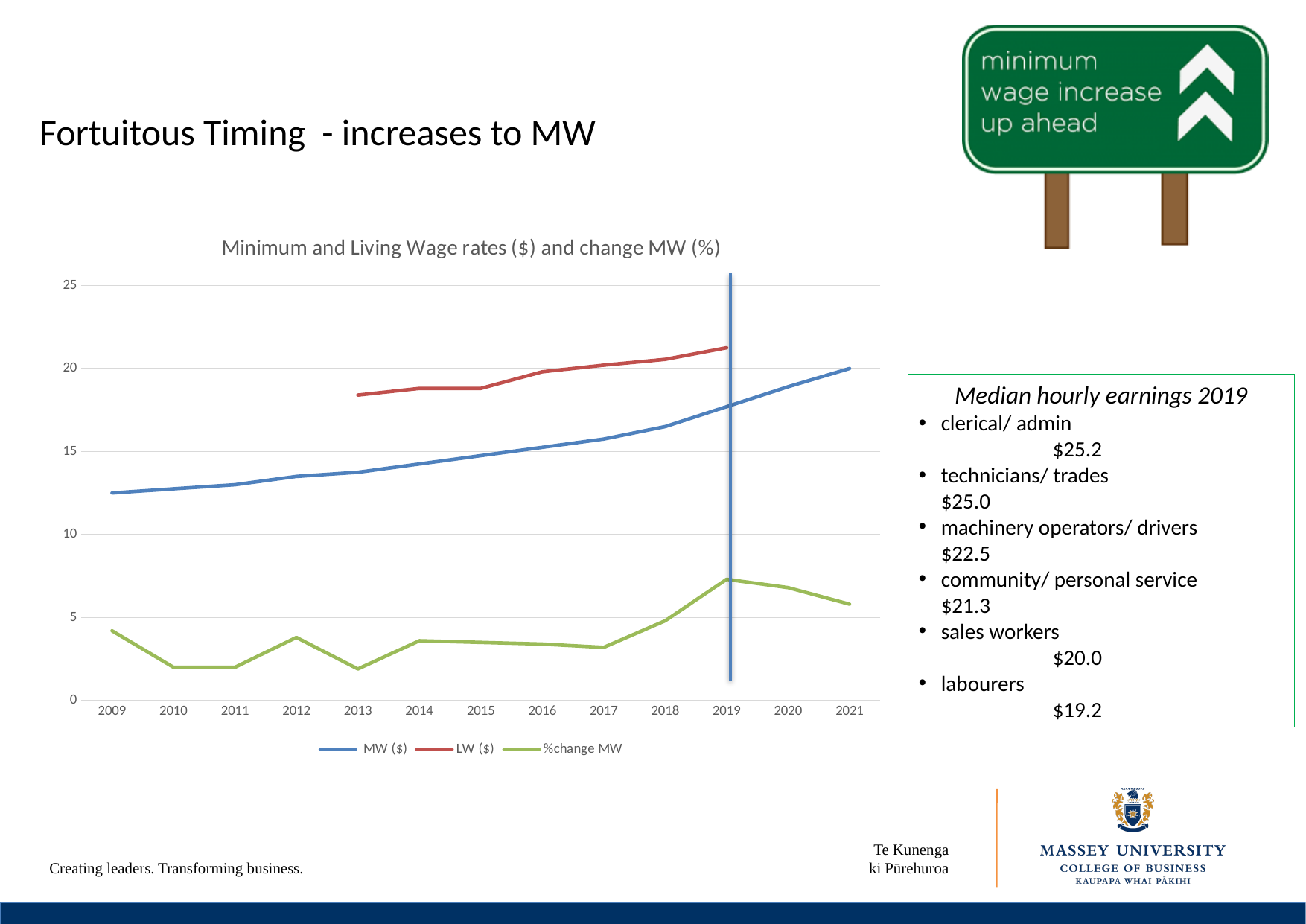
How many years are shown along the x axis of the chart? 13 In which year is the MW ($) series at its highest? 2021 Is the value for LW ($) in 2013 greater or less than 15? greater In 2019, which is larger, the LW ($) value or the MW ($) value? LW ($) How many series does the chart legend list? 3 What kind of chart is shown on the slide? line chart What is the title of the chart? Minimum and Living Wage rates ($) and change MW (%) In which year does the %change MW series reach its highest value? 2019 Does the MW ($) series rise or fall from 2009 to 2021? rise Which series are listed in the chart legend? MW ($), LW ($), %change MW Is the value for MW ($) in 2009 greater or less than 15? less Is the value for %change MW in 2019 greater or less than 5? greater